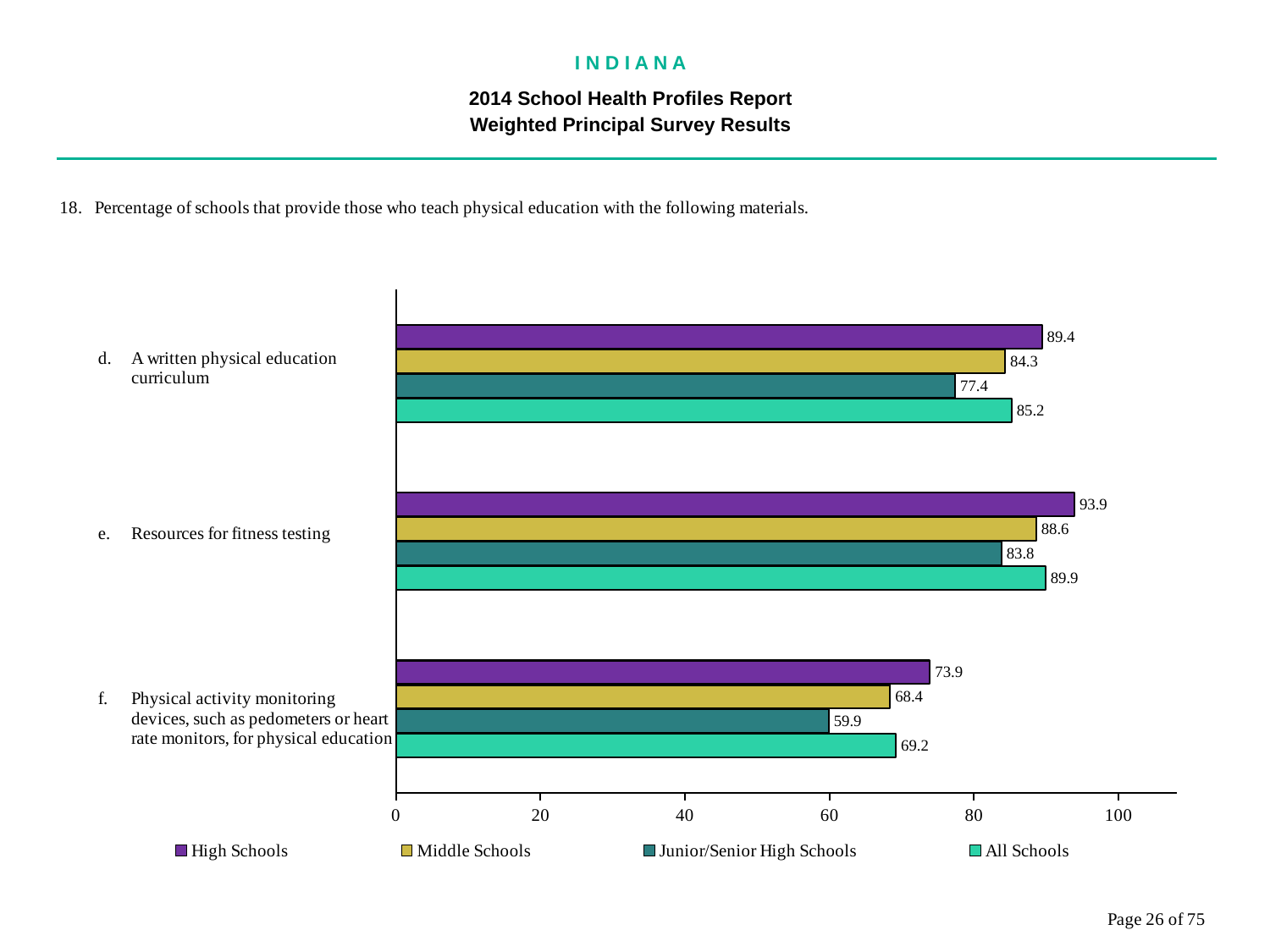
What is the value for All Schools for 'Physical activity monitoring devices, such as pedometers or heart rate monitors, for physical education'? 69.2 Which category has the highest value for Middle Schools? Resources for fitness testing What is the value for High Schools for 'Resources for fitness testing'? 93.9 Which category has the lowest value for Junior/Senior High Schools? Physical activity monitoring devices, such as pedometers or heart rate monitors, for physical education Which series is shown in purple in the legend? High Schools What is the difference between the High Schools and Middle Schools values for 'A written physical education curriculum'? 5.1 What kind of chart is shown on the slide? bar chart What is the value for Junior/Senior High Schools for 'A written physical education curriculum'? 77.4 How many categories are shown in the chart? 3 Which is larger for 'Resources for fitness testing': the Middle Schools value or the All Schools value? All Schools How many series does the legend list? 4 Is the value for Junior/Senior High Schools for 'Physical activity monitoring devices' greater or less than 60? less